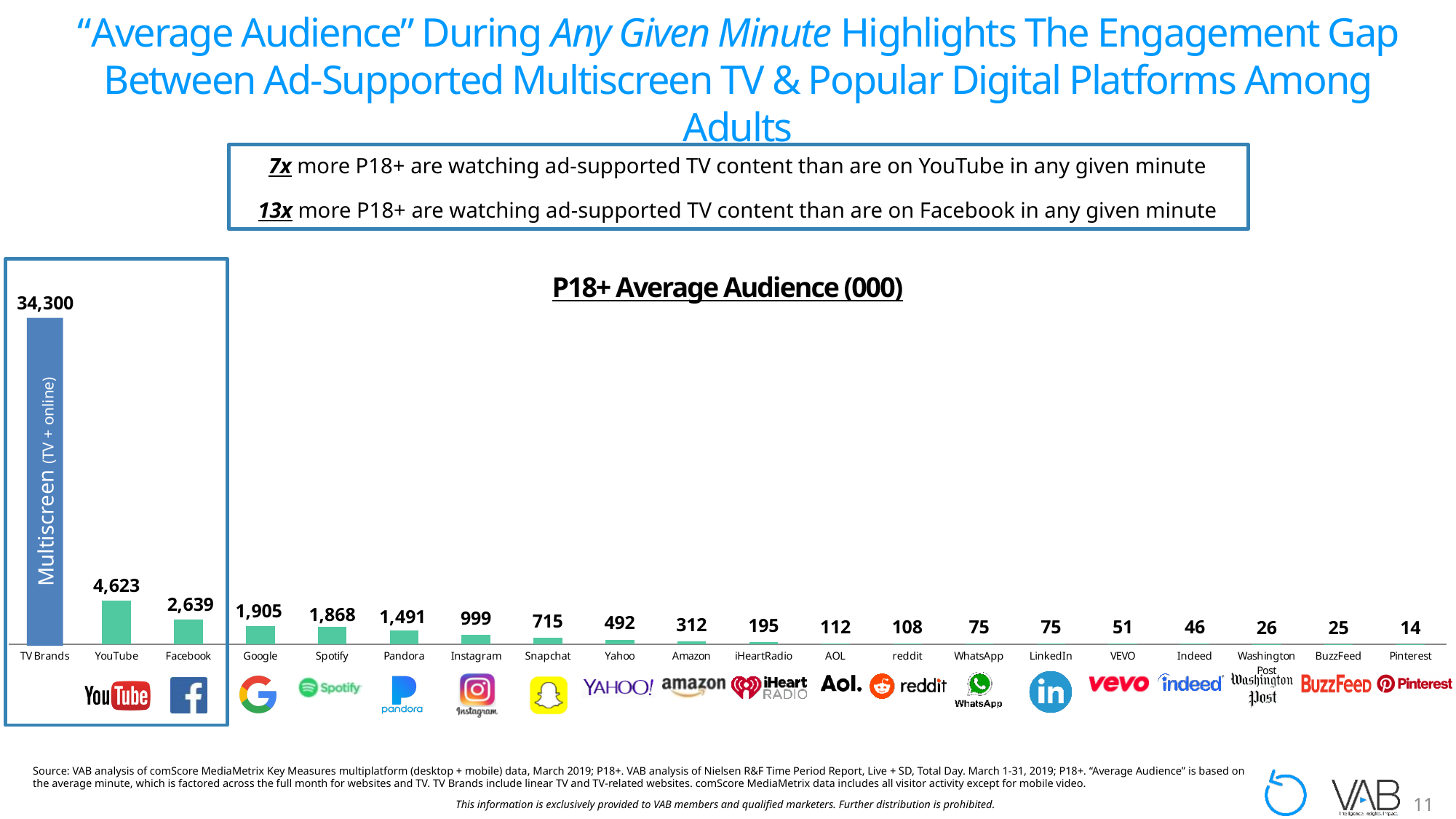
What is the P18+ average audience (000) for Pinterest? 14 What is the P18+ average audience (000) for TV Brands? 34,300 What is the title of the chart? P18+ Average Audience (000) What kind of chart is shown on the slide? Bar chart Which category has the highest P18+ average audience? TV Brands How many categories are shown on the chart? 20 What is the difference between the YouTube and Facebook values? 1,984 Which has a larger P18+ average audience, Google or Spotify? Google What is the P18+ average audience (000) for YouTube? 4,623 Which category has the lowest P18+ average audience? Pinterest What is the P18+ average audience (000) for Snapchat? 715 Do the values rise or fall moving from left to right along the x axis? Fall